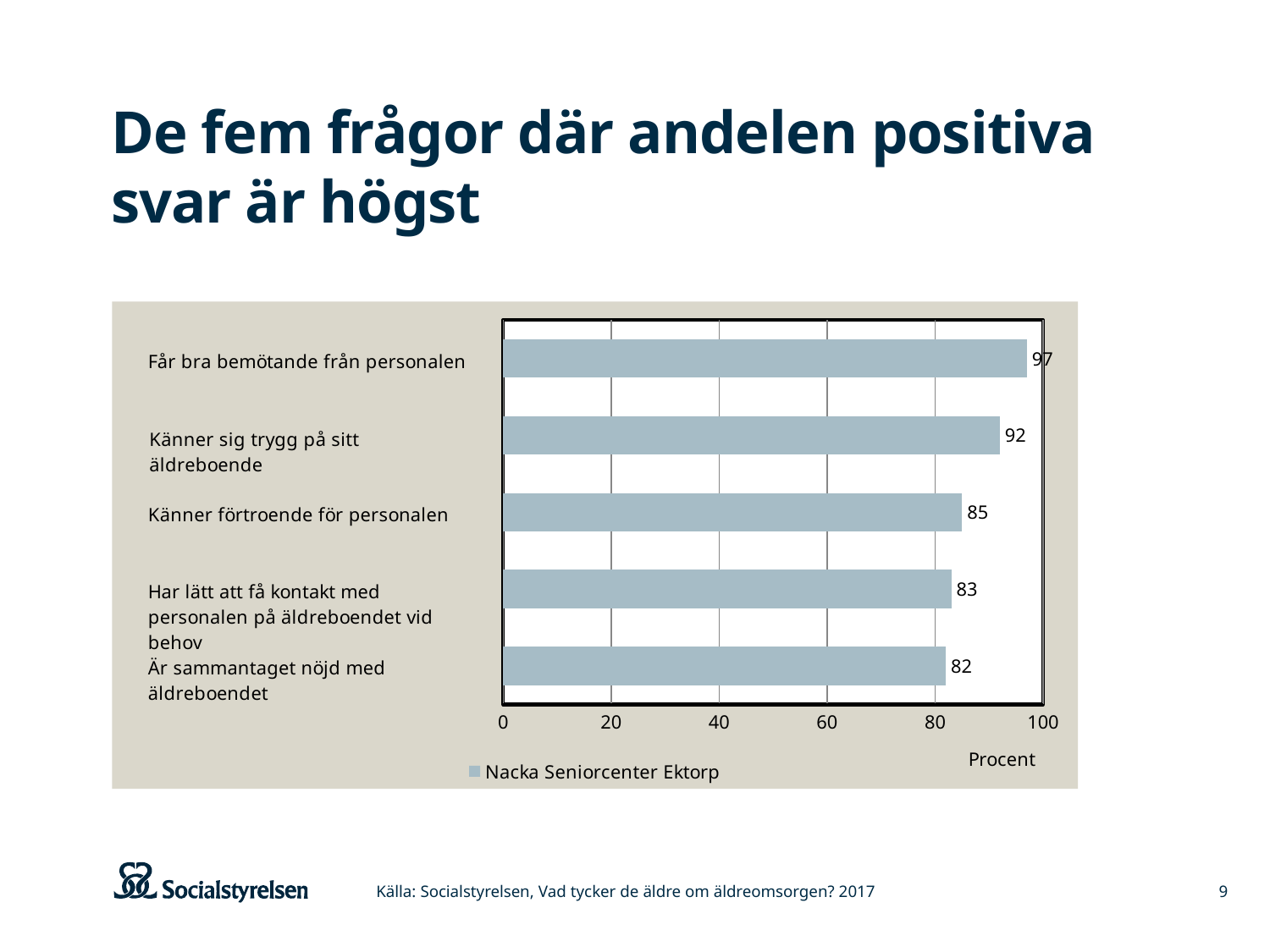
What is the value for "Känner förtroende för personalen"? 85 Which category has the highest value? Får bra bemötande från personalen What is the difference between the values for "Får bra bemötande från personalen" and "Känner sig trygg på sitt äldreboende"? 5 Which is larger: the value for "Känner förtroende för personalen" or the value for "Har lätt att få kontakt med personalen på äldreboendet vid behov"? Känner förtroende för personalen What series name does the legend show? Nacka Seniorcenter Ektorp Is the value for "Känner sig trygg på sitt äldreboende" greater or less than 80? greater What is the value for "Får bra bemötande från personalen"? 97 What is the value for "Är sammantaget nöjd med äldreboendet"? 82 What kind of chart is shown on the slide? Bar chart How many categories are shown in the chart? 5 What is the value for "Känner sig trygg på sitt äldreboende"? 92 Which category has the lowest value? Är sammantaget nöjd med äldreboendet